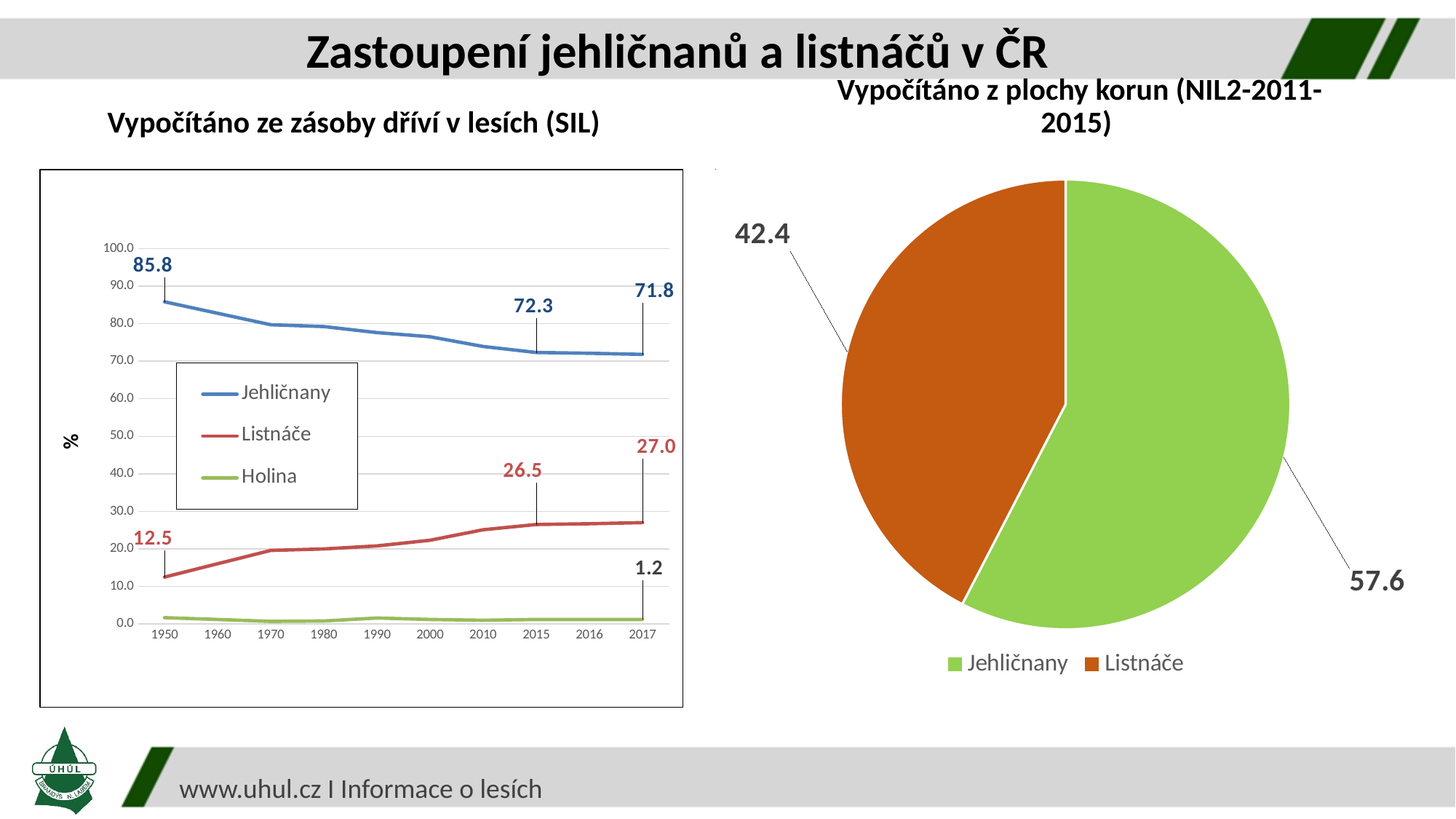
What kind of chart is the left chart (Vypočítáno ze zásoby dříví v lesích (SIL))? line chart How many series does the legend of the left chart (Vypočítáno ze zásoby dříví v lesích (SIL)) list? 3 In the left chart (Vypočítáno ze zásoby dříví v lesích (SIL)), does the Listnáče series rise or fall from 1950 to 2017? rise In the left chart (Vypočítáno ze zásoby dříví v lesích (SIL)), is the value for Jehličnany in 1980 greater or less than 70.0? greater In the left chart (Vypočítáno ze zásoby dříví v lesích (SIL)), by how much did the Jehličnany value fall between 1950 and 2017? 14.0 In the right chart (Vypočítáno z plochy korun (NIL2-2011-2015)), which slice is larger, Jehličnany or Listnáče? Jehličnany In the left chart (Vypočítáno ze zásoby dříví v lesích (SIL)), what is the value for Jehličnany in 1950? 85.8 In the left chart (Vypočítáno ze zásoby dříví v lesích (SIL)), what is the value for Holina in 2017? 1.2 In the left chart (Vypočítáno ze zásoby dříví v lesích (SIL)), what is the difference between Jehličnany and Listnáče in 2015? 45.8 What kind of chart is the right chart (Vypočítáno z plochy korun (NIL2-2011-2015))? pie chart In the right chart (Vypočítáno z plochy korun (NIL2-2011-2015)), what is the value for Listnáče? 42.4 In the left chart (Vypočítáno ze zásoby dříví v lesích (SIL)), what is the value for Listnáče in 2017? 27.0